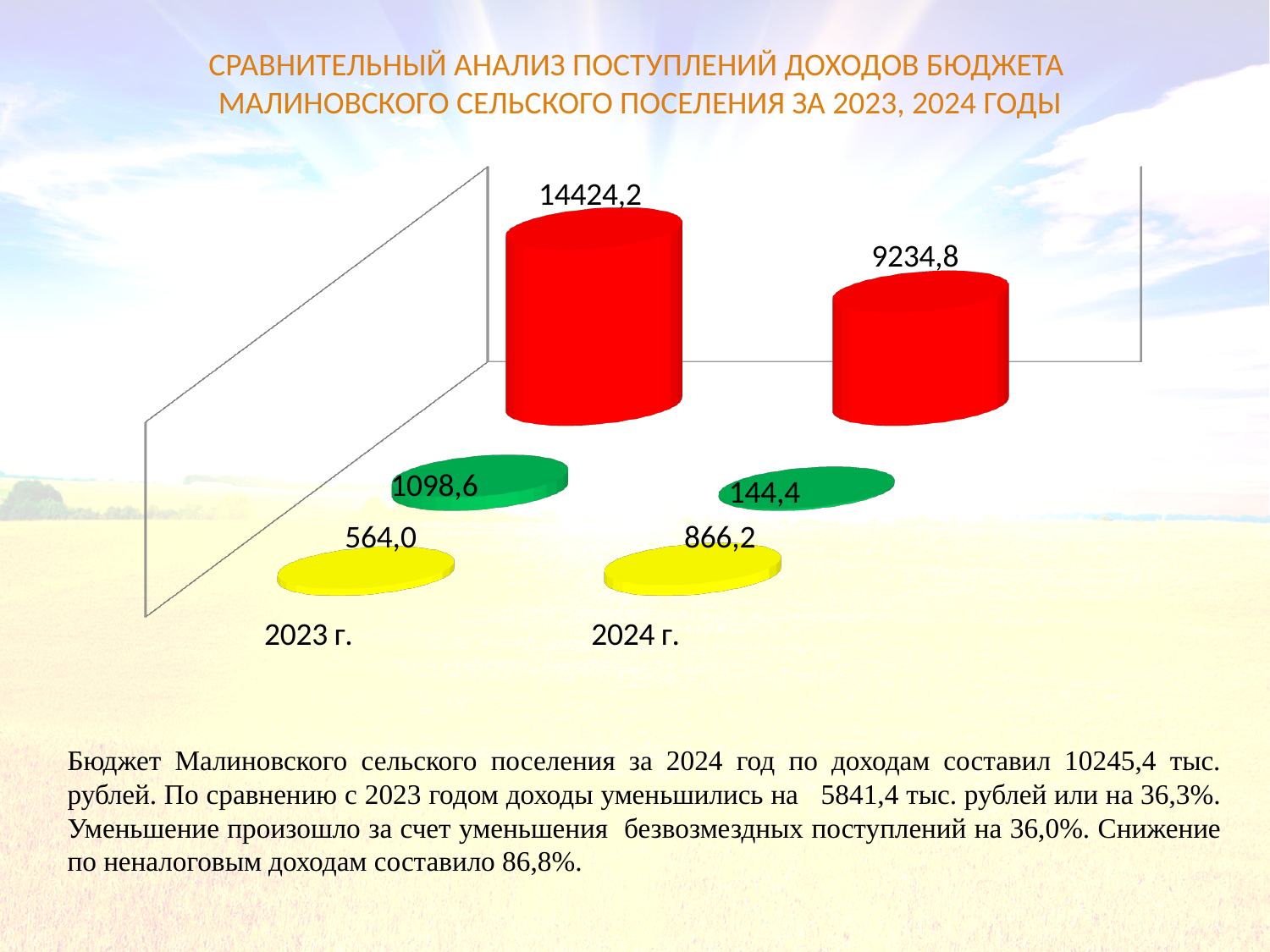
What is the value of the green series for 2024 г.? 144,4 What is the difference between the green series values for 2023 г. and 2024 г.? 954,2 By how much did the red series value decrease from 2023 г. to 2024 г.? 5189,4 What is the value of the red series for 2024 г.? 9234,8 What is the value of the yellow series for 2024 г.? 866,2 Which year has the higher value for the yellow series? 2024 г. Which year has the higher value for the red series? 2023 г. What is the value of the yellow series for 2023 г.? 564,0 What is the value of the red series for 2023 г.? 14424,2 What is the value of the green series for 2023 г.? 1098,6 How many year categories are shown on the chart? 2 Does the green series rise or fall from 2023 г. to 2024 г.? fall